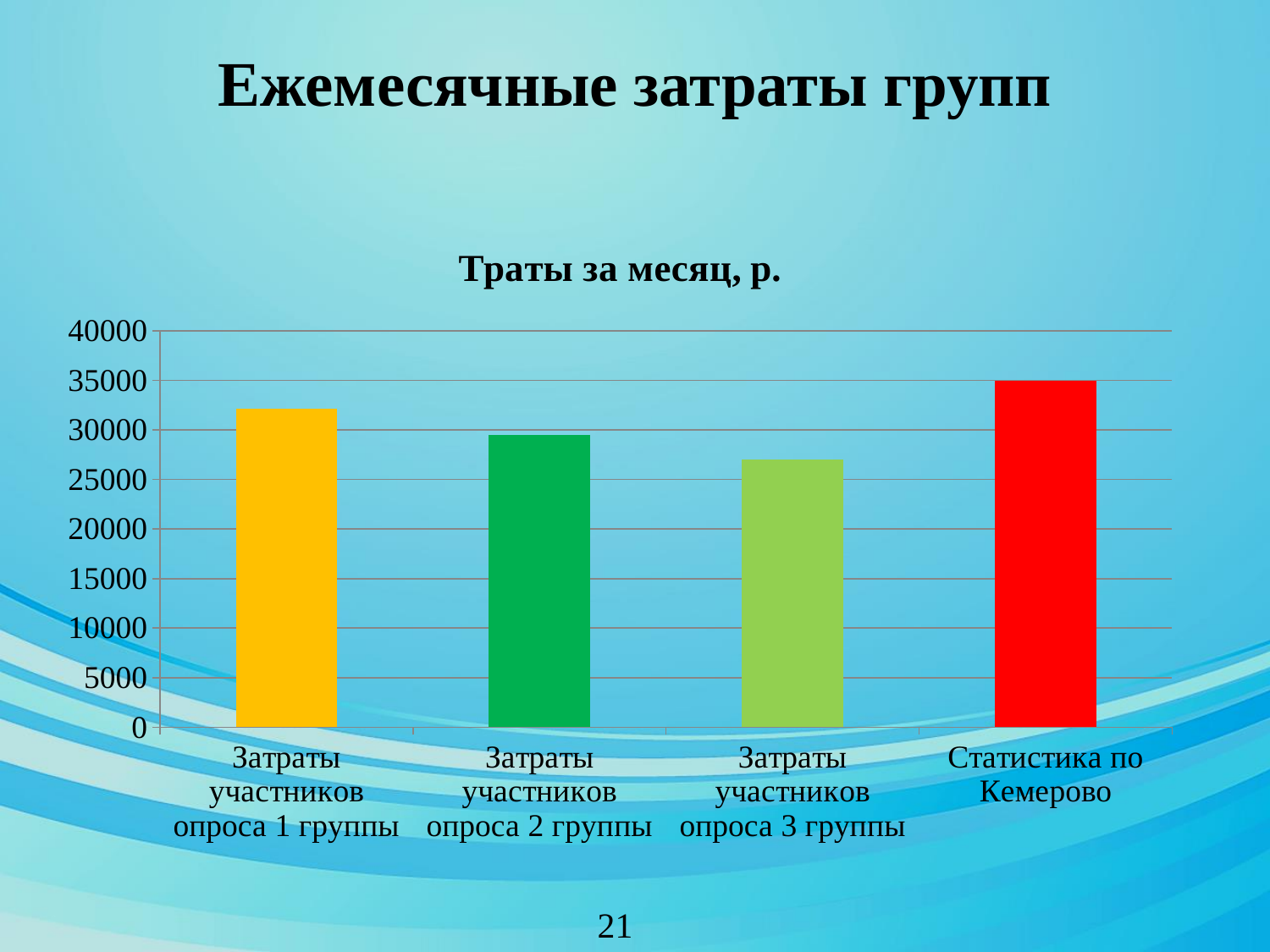
Is the value for Затраты участников опроса 3 группы greater or less than 25000? greater What colour is the bar for Статистика по Кемерово? red How many bars (categories) does the chart show? 4 Which category has the lowest value? Затраты участников опроса 3 группы Is the value for Затраты участников опроса 1 группы greater or less than 30000? greater What is the value for Статистика по Кемерово? 35000 What is the title of the chart? Траты за месяц, р. Which category has the highest value? Статистика по Кемерово Which is larger: the value for Затраты участников опроса 1 группы or Затраты участников опроса 2 группы? Затраты участников опроса 1 группы What kind of chart is shown on the slide? bar chart Do the values rise or fall across the three survey groups (group 1 to group 3)? fall